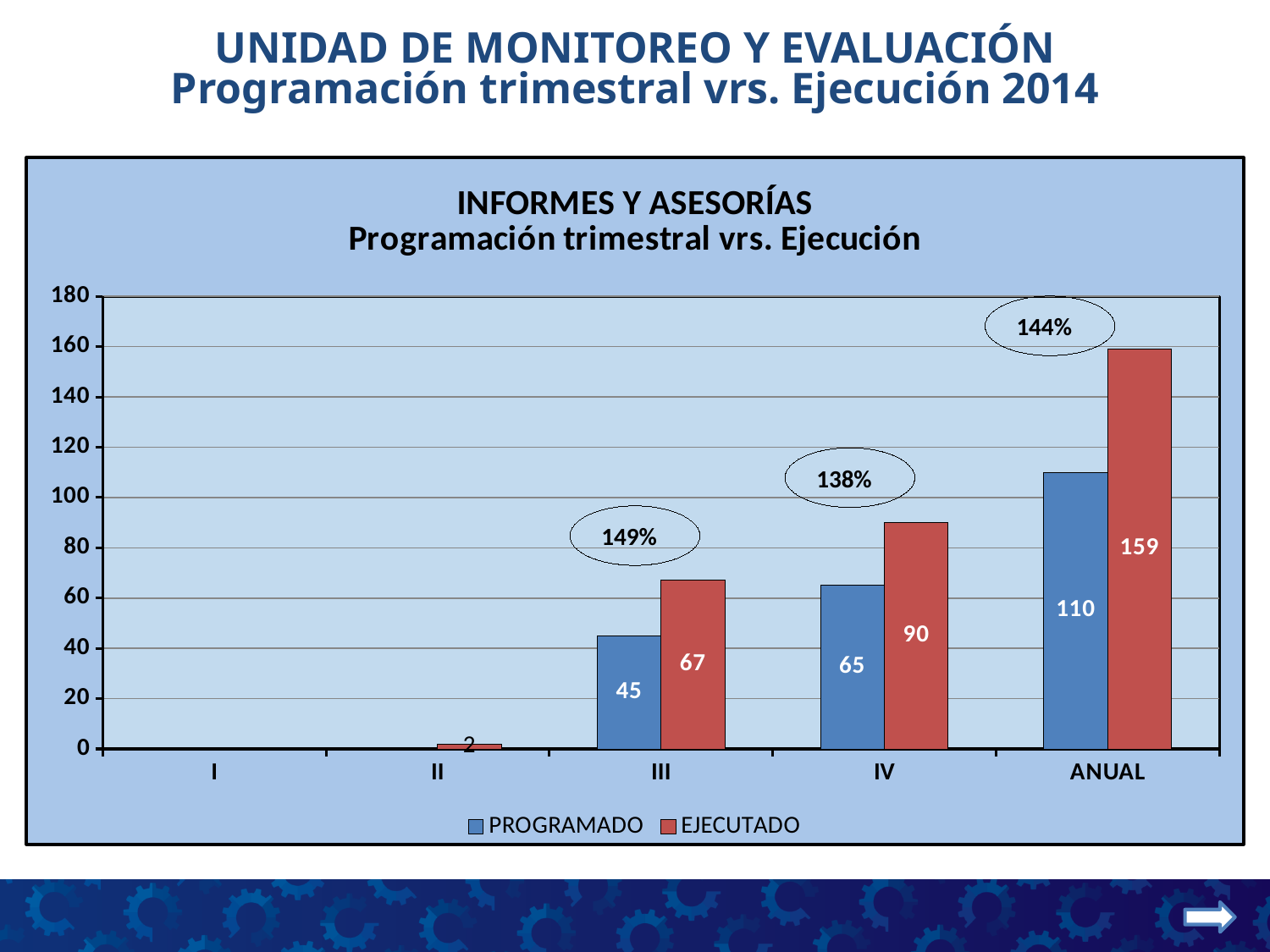
What is the PROGRAMADO value for ANUAL? 110 How many series does the legend list? 2 Which is larger for category III, PROGRAMADO or EJECUTADO? EJECUTADO What kind of chart is shown on the slide? Bar chart What is the difference between the EJECUTADO and PROGRAMADO values for ANUAL? 49 What is the EJECUTADO value for ANUAL? 159 How many categories are shown on the x axis? 5 What is the EJECUTADO value for category III? 67 What is the PROGRAMADO value for category IV? 65 What is the difference between the EJECUTADO and PROGRAMADO values for category IV? 25 What percentage is shown in the circle above the ANUAL bars? 144% Which category has the highest EJECUTADO value? ANUAL